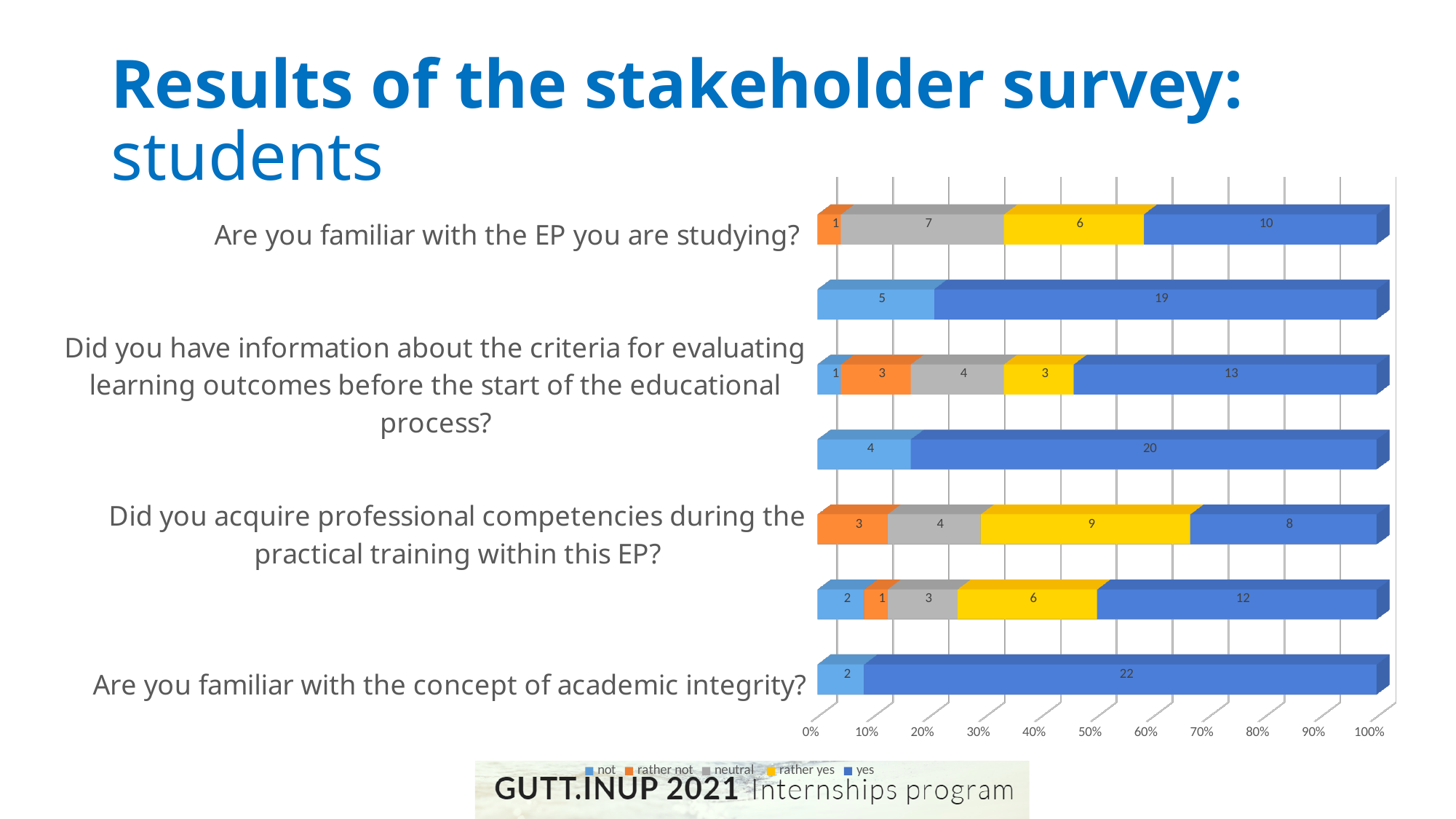
Which legend entry is shown in orange? rather not Which question has the larger "yes" value: "Are you familiar with the concept of academic integrity?" or "Are you familiar with the EP you are studying?" Are you familiar with the concept of academic integrity? What kind of chart is shown on the slide? Stacked bar chart What is the "rather yes" value for "Did you acquire professional competencies during the practical training within this EP?" 9 How many bars are plotted in the chart? 7 What is the "yes" value for "Did you have information about the criteria for evaluating learning outcomes before the start of the educational process?" 13 For "Did you acquire professional competencies during the practical training within this EP?", which response category has the largest value? rather yes What is the total of all segments in the bar for "Are you familiar with the EP you are studying?" 24 What is the "neutral" value for "Are you familiar with the EP you are studying?" 7 For "Did you acquire professional competencies during the practical training within this EP?", what is the difference between the "rather yes" and "yes" values? 1 How many students answered "yes" to "Are you familiar with the concept of academic integrity?" 22 How many series does the legend list? 5